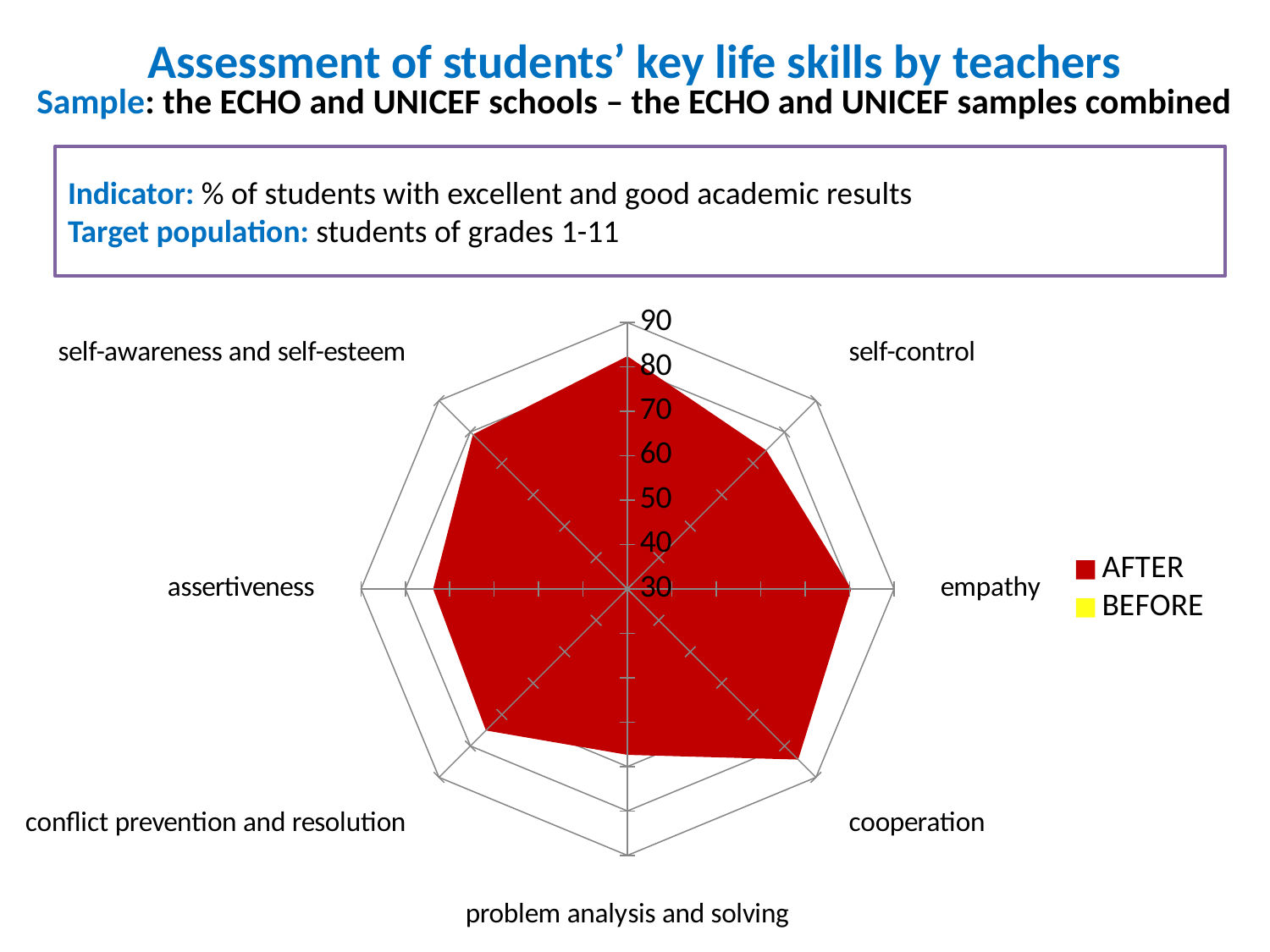
How many series does the legend list? 2 Is the AFTER value for cooperation greater or less than 70? greater Which has the larger AFTER value, empathy or problem analysis and solving? empathy Which series is drawn in red on the chart? AFTER What kind of chart is shown on the slide? radar chart Is the AFTER value for assertiveness greater or less than 80? less Among the labelled skills, which has the lowest AFTER value? problem analysis and solving Is the AFTER value for problem analysis and solving greater or less than 80? less What is the highest value shown on the chart's axis scale? 90 Which has the larger AFTER value, cooperation or problem analysis and solving? cooperation